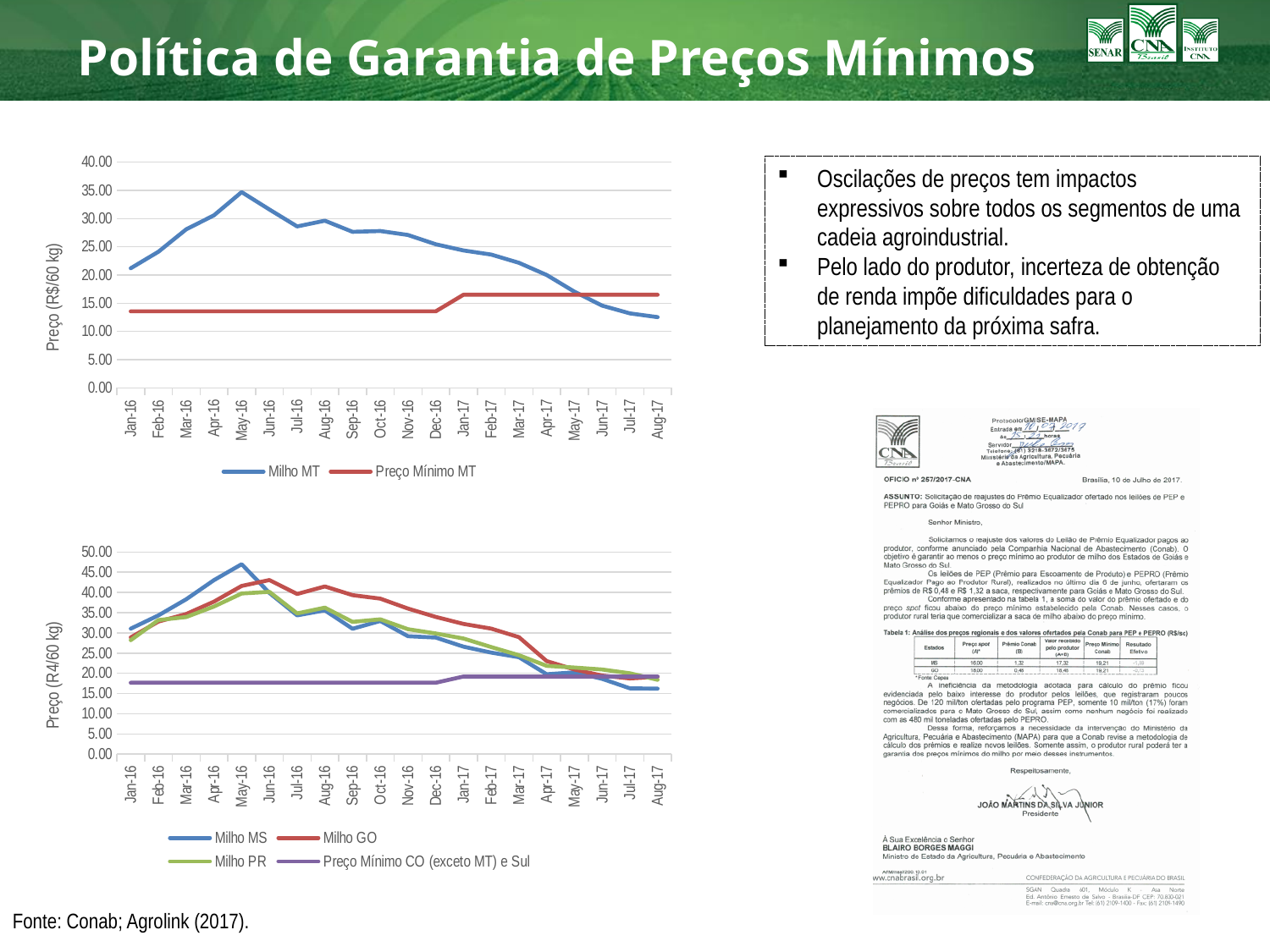
In the top chart, which is larger in May-16: Milho MT or Preço Mínimo MT? Milho MT In the top chart, is the value of Milho MT in May-16 greater or less than 30.00? greater In the top chart, in which month does the Milho MT line reach its highest value? May-16 In the bottom chart, is the value of Milho MS in Aug-17 greater or less than 20.00? less How many months are shown on the x axis of the top chart? 20 In the top chart, does the Milho MT line rise or fall from May-16 to Aug-17? Fall In the bottom chart, which series has the highest value in May-16? Milho MS What is the y-axis label of the top chart? Preço (R$/60 kg) How many series does the legend of the top chart list? 2 What type of chart is the top chart on the slide? Line chart How many series does the legend of the bottom chart list? 4 In the top chart, is the value of Milho MT in Aug-17 greater or less than 15.00? less